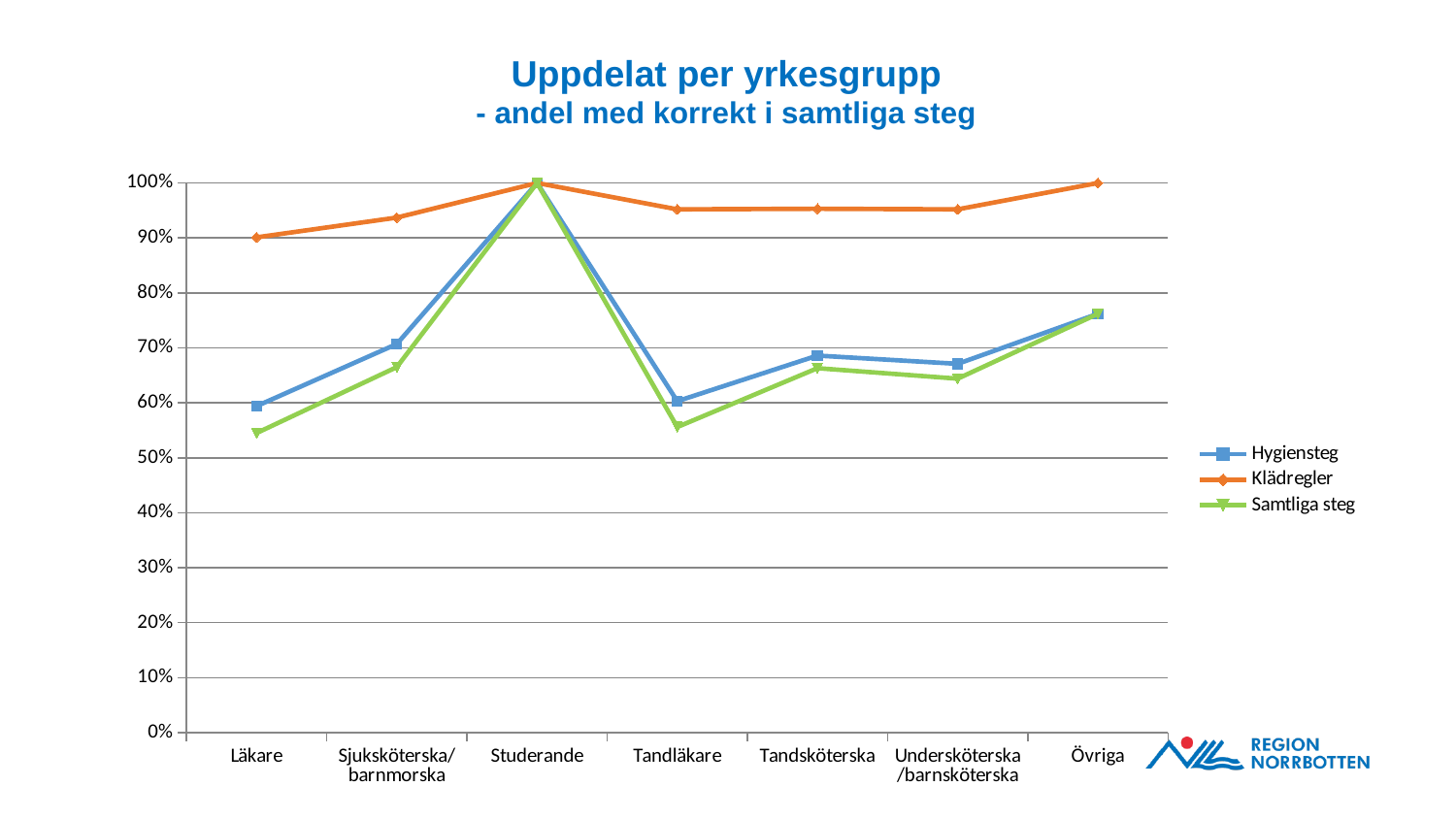
What is the value for Samtliga steg for Studerande? 100% For which category is Samtliga steg highest? Studerande For which category is Klädregler lowest? Läkare What kind of chart is shown on the slide? line chart Is the value for Samtliga steg for Tandläkare greater or less than 60%? less How many occupational groups (categories) are shown on the x axis? 7 Is the value for Klädregler for Tandläkare greater or less than 90%? greater For Läkare, which is larger: Hygiensteg or Samtliga steg? Hygiensteg Does the Hygiensteg line rise or fall from Studerande to Tandläkare? fall How many series does the legend list? 3 What is the value for Klädregler for Övriga? 100%